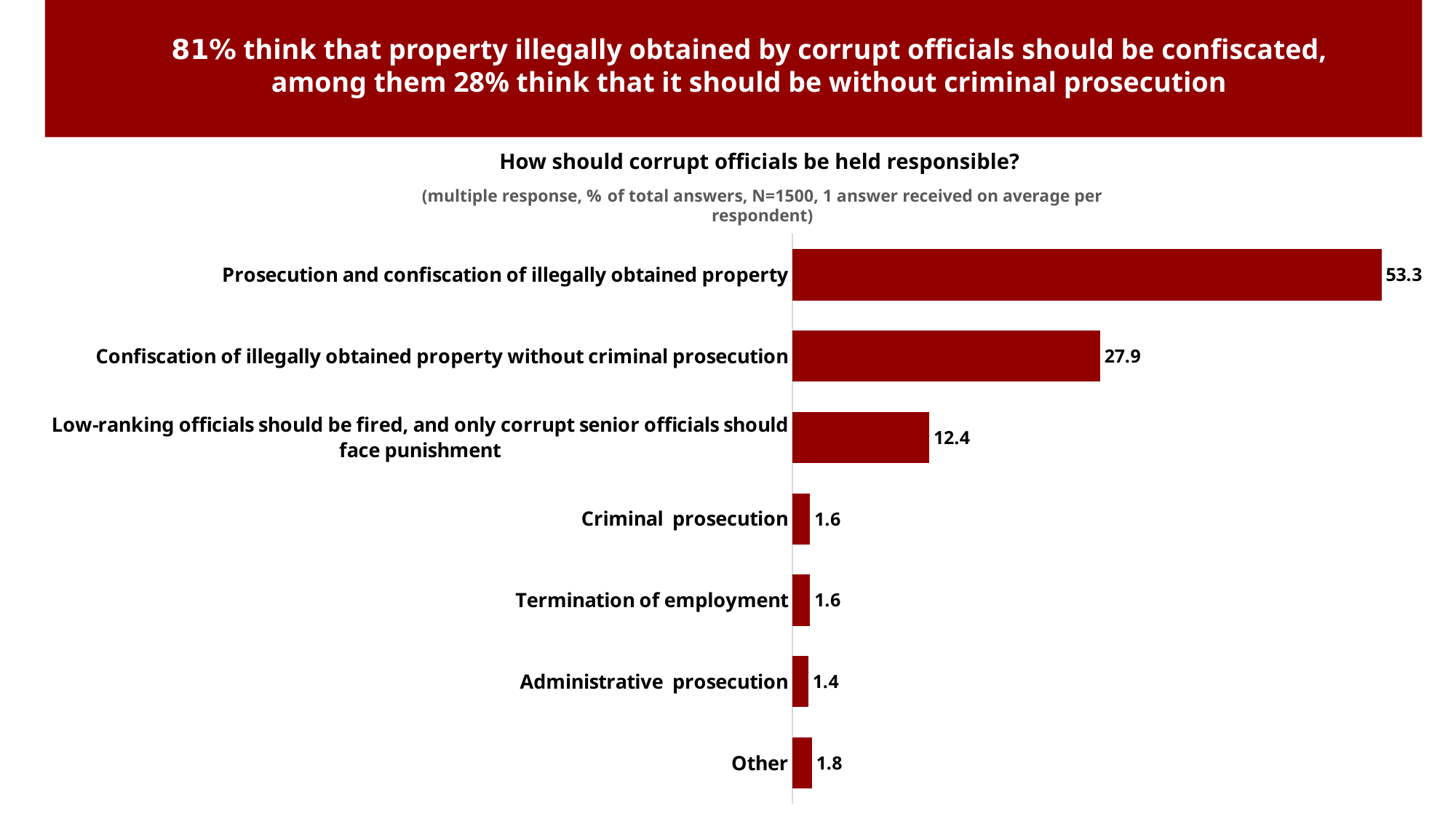
What kind of chart is shown on the slide? Bar chart What is the value for 'Administrative prosecution'? 1.4 How many categories are shown in the chart? 7 Which category has the highest value? Prosecution and confiscation of illegally obtained property What is the title of the chart? How should corrupt officials be held responsible? What is the value for 'Other'? 1.8 What is the value for 'Confiscation of illegally obtained property without criminal prosecution'? 27.9 Which category has the lowest value? Administrative prosecution What is the difference between the values for 'Prosecution and confiscation of illegally obtained property' and 'Confiscation of illegally obtained property without criminal prosecution'? 25.4 What is the value for 'Prosecution and confiscation of illegally obtained property'? 53.3 Which is larger: the value for 'Other' or the value for 'Termination of employment'? Other What is the value for 'Low-ranking officials should be fired, and only corrupt senior officials should face punishment'? 12.4